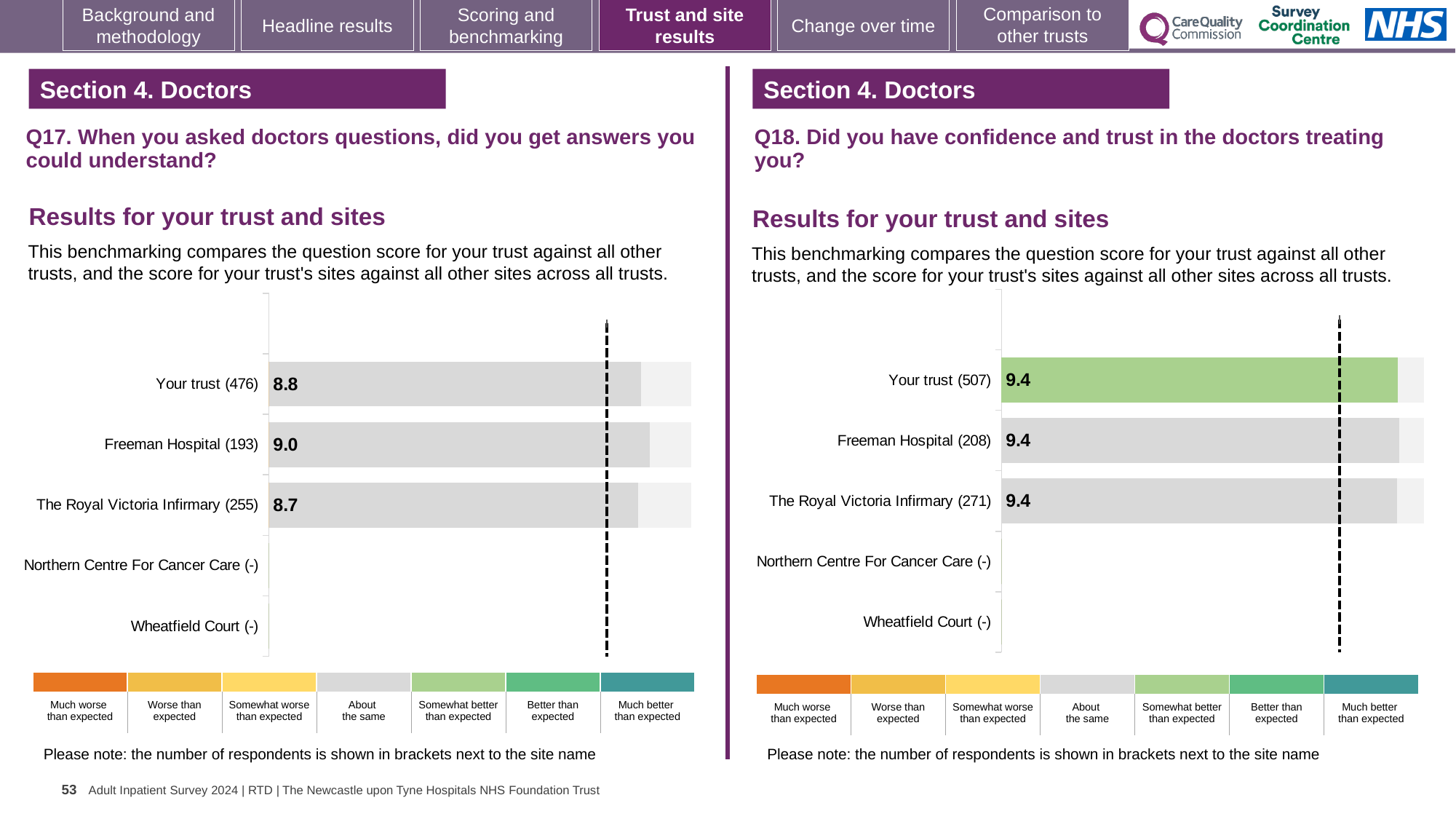
On the Q17 chart (left), what is the difference between the Freeman Hospital score and The Royal Victoria Infirmary score? 0.3 On the Q18 chart (right), what is the score for The Royal Victoria Infirmary? 9.4 On the Q17 chart (left), which site has the highest score? Freeman Hospital What kind of chart is used on the Q18 chart (right)? Bar chart On the Q17 chart (left), what is the score for Your trust? 8.8 On the Q17 chart (left), which site has the lowest score among those with a bar? The Royal Victoria Infirmary How many site rows (including Your trust) are listed on the Q17 chart (left)? 5 On the Q17 chart (left), which is larger, the score for Your trust or the score for Freeman Hospital? Freeman Hospital On the Q17 chart (left), what is the score for Freeman Hospital? 9.0 On the Q17 chart (left), what is the score for The Royal Victoria Infirmary? 8.7 On the Q18 chart (right), how many respondents are shown for Freeman Hospital? 208 On the Q18 chart (right), what is the score for Your trust? 9.4